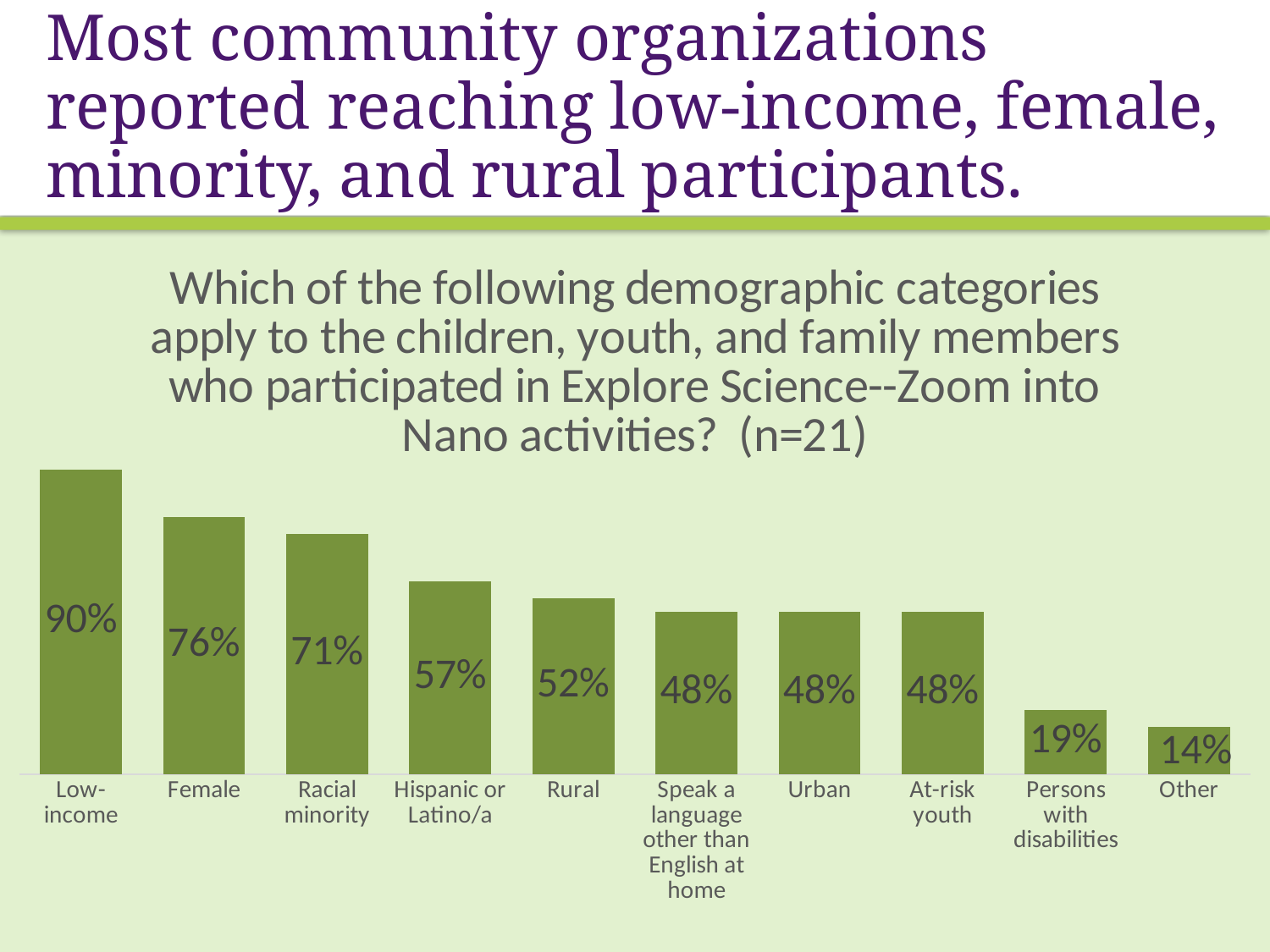
Do the values rise or fall from left to right across the categories? Fall What is the value for Rural? 52% Which demographic category has the highest value? Low-income What is the difference between the values for Low-income and Other? 76% What is the value for Persons with disabilities? 19% What kind of chart is shown on the slide? Bar chart Which is larger, the value for Hispanic or Latino/a or the value for Urban? Hispanic or Latino/a How many demographic categories are shown in the chart? 10 Which demographic category has the lowest value? Other What percentage of organizations reported reaching low-income participants? 90% How many categories share the value 48%? 3 What is the difference between the values for Female and Racial minority? 5%